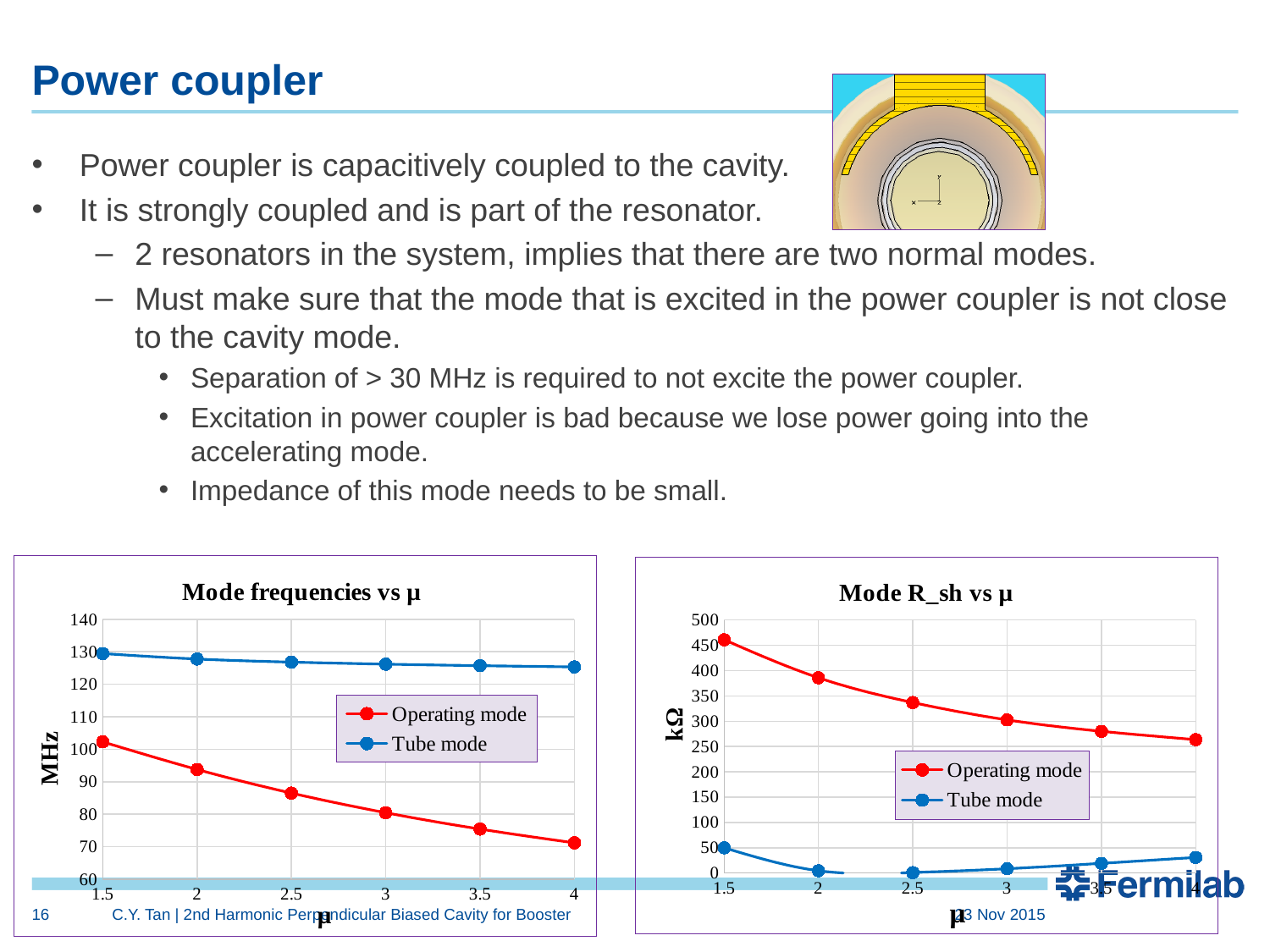
In the 'Mode R_sh vs μ' chart, does the Operating mode R_sh rise or fall as μ increases from 1.5 to 4? fall In the 'Mode R_sh vs μ' chart, is the Operating mode value at μ = 4 greater or less than 250? greater In the 'Mode frequencies vs μ' chart, does the Operating mode frequency rise or fall as μ increases? fall In the 'Mode R_sh vs μ' chart, how many series does the legend list? 2 In the 'Mode frequencies vs μ' chart, at μ = 3, which series has the higher value, Operating mode or Tube mode? Tube mode What is the y-axis label of the 'Mode R_sh vs μ' chart? kΩ In the 'Mode R_sh vs μ' chart, at which value of μ is the Operating mode R_sh highest? 1.5 In the 'Mode R_sh vs μ' chart, is the Tube mode value at μ = 4 greater or less than 50? less In the 'Mode frequencies vs μ' chart, is the Tube mode value at μ = 4 greater or less than 130? less In the 'Mode frequencies vs μ' chart, what kind of chart is shown? line chart In the 'Mode frequencies vs μ' chart, how many data points are plotted for the Operating mode series? 6